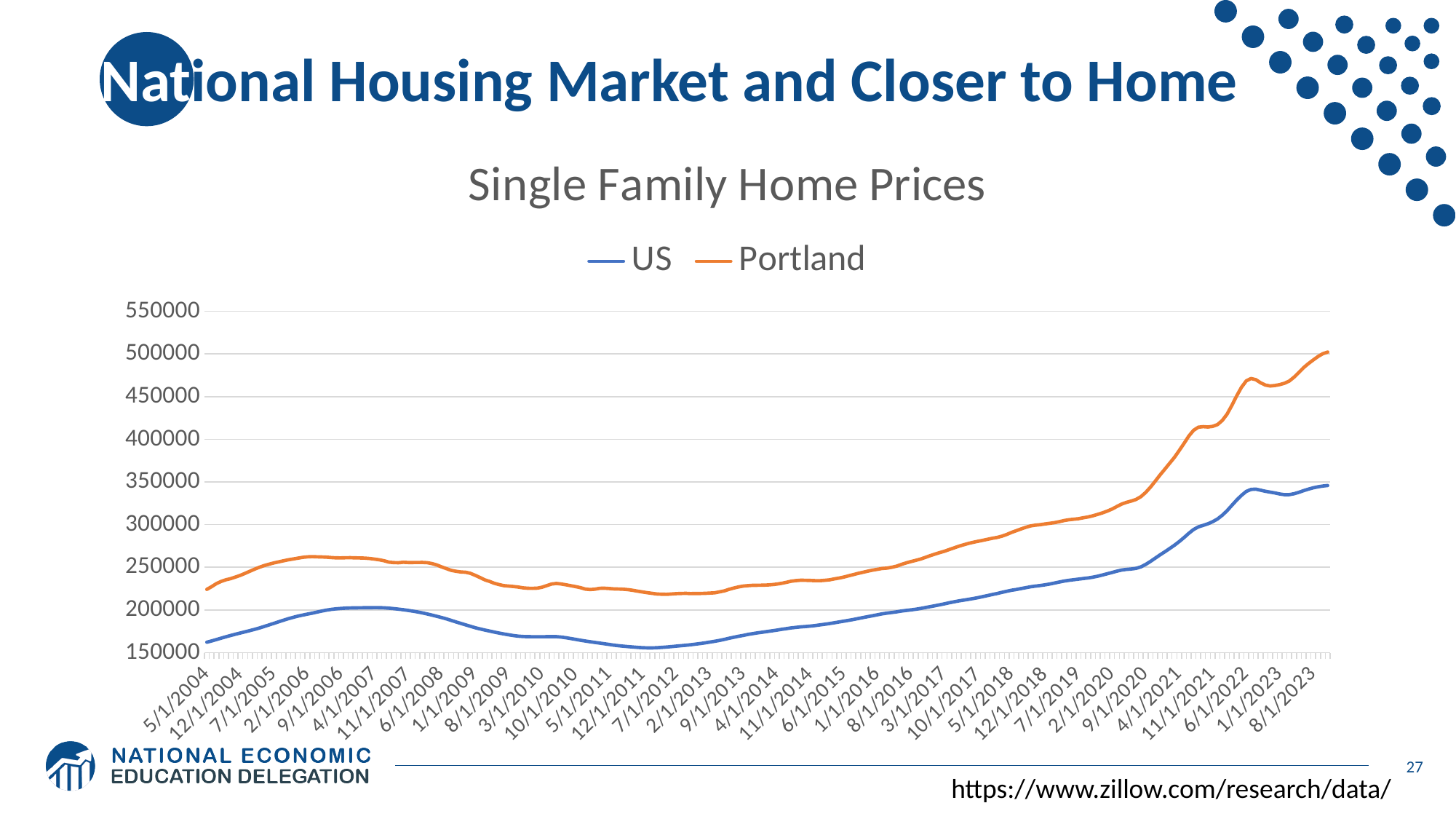
What is the title of the chart? Single Family Home Prices Is the value for Portland at 8/1/2023 greater or less than 450000? greater Is the value for Portland at 7/1/2012 greater or less than 250000? less At 8/1/2023, which series has the higher value, US or Portland? Portland Does the US line rise or fall between 7/1/2012 and 8/1/2023? rise Is the value for US at 5/1/2004 greater or less than 200000? less What kind of chart is shown on the slide? line chart How many series does the legend list? 2 Which series reaches the highest value on the chart? Portland Which colour is used for the Portland line? orange Does the Portland line rise or fall between 9/1/2006 and 7/1/2012? fall